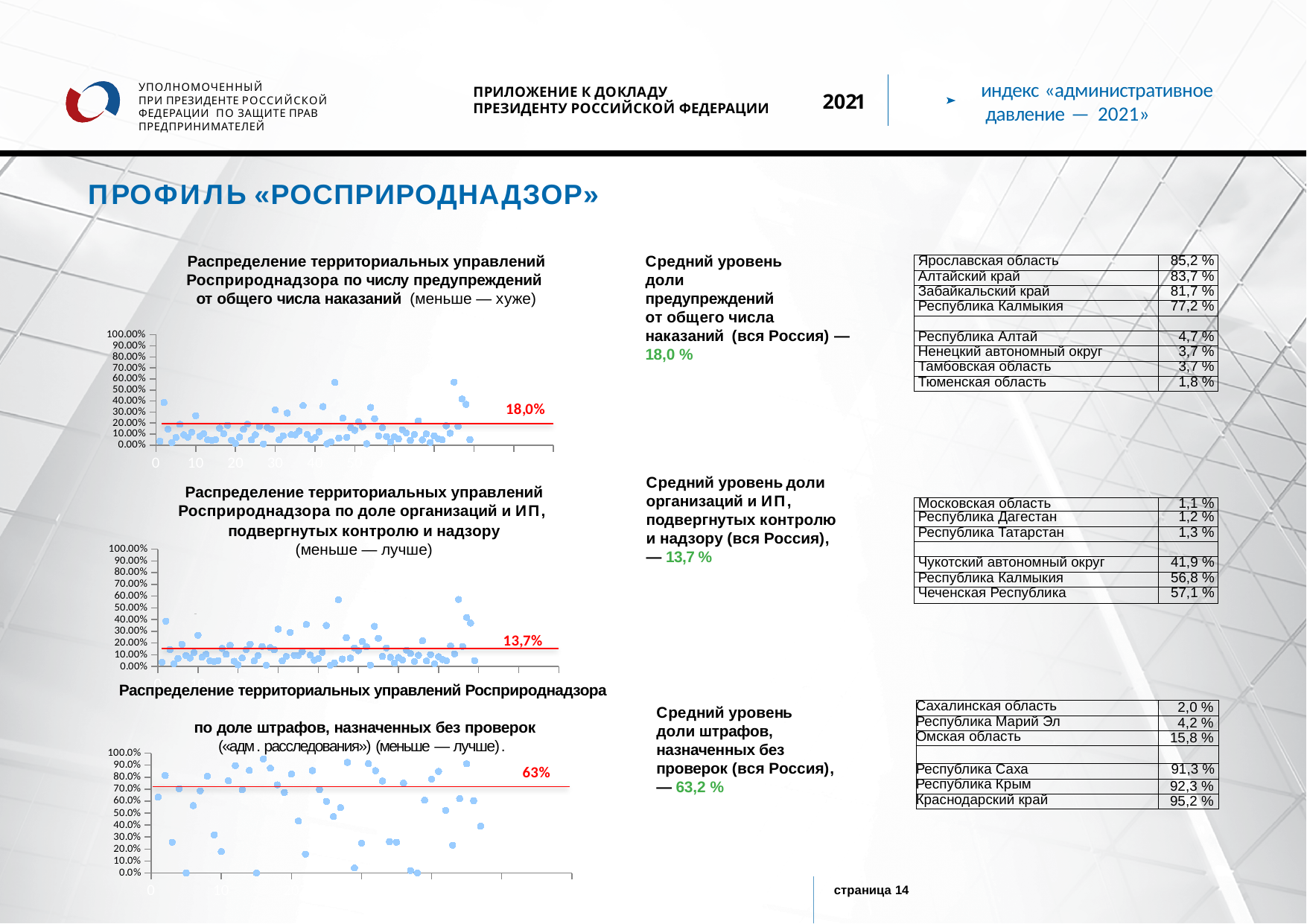
In the middle chart on organisations under control, is the red reference line above or below 20.00% on the y axis? below What is the difference between the reference line value in the top chart (18,0%) and the reference line value in the middle chart (13,7%)? 4,3% In the bottom chart on fines imposed without inspections, is the red reference line above or below 50.0% on the y axis? above In the bottom chart on the share of fines imposed without inspections, what value is printed on the red reference line? 63% In the top chart on the number of warnings as a share of total penalties, what value is printed on the red reference line? 18,0% In the middle chart on the share of organisations and sole proprietors subjected to control and supervision, what value is printed on the red reference line? 13,7% What type of chart is the top chart, 'Распределение территориальных управлений Росприроднадзора по числу предупреждений от общего числа наказаний'? scatter chart How many scatter charts are shown on the slide? 3 Which chart has the highest red reference line value: the top chart (warnings), the middle chart (organisations under control), or the bottom chart (fines without inspections)? the bottom chart (fines without inspections) What is the maximum value shown on the y axis of the top chart? 100.00% Is the red reference line in the top chart (warnings share) higher or lower than the red reference line in the middle chart (organisations under control)? higher What colour are the data points in the three scatter charts? light blue